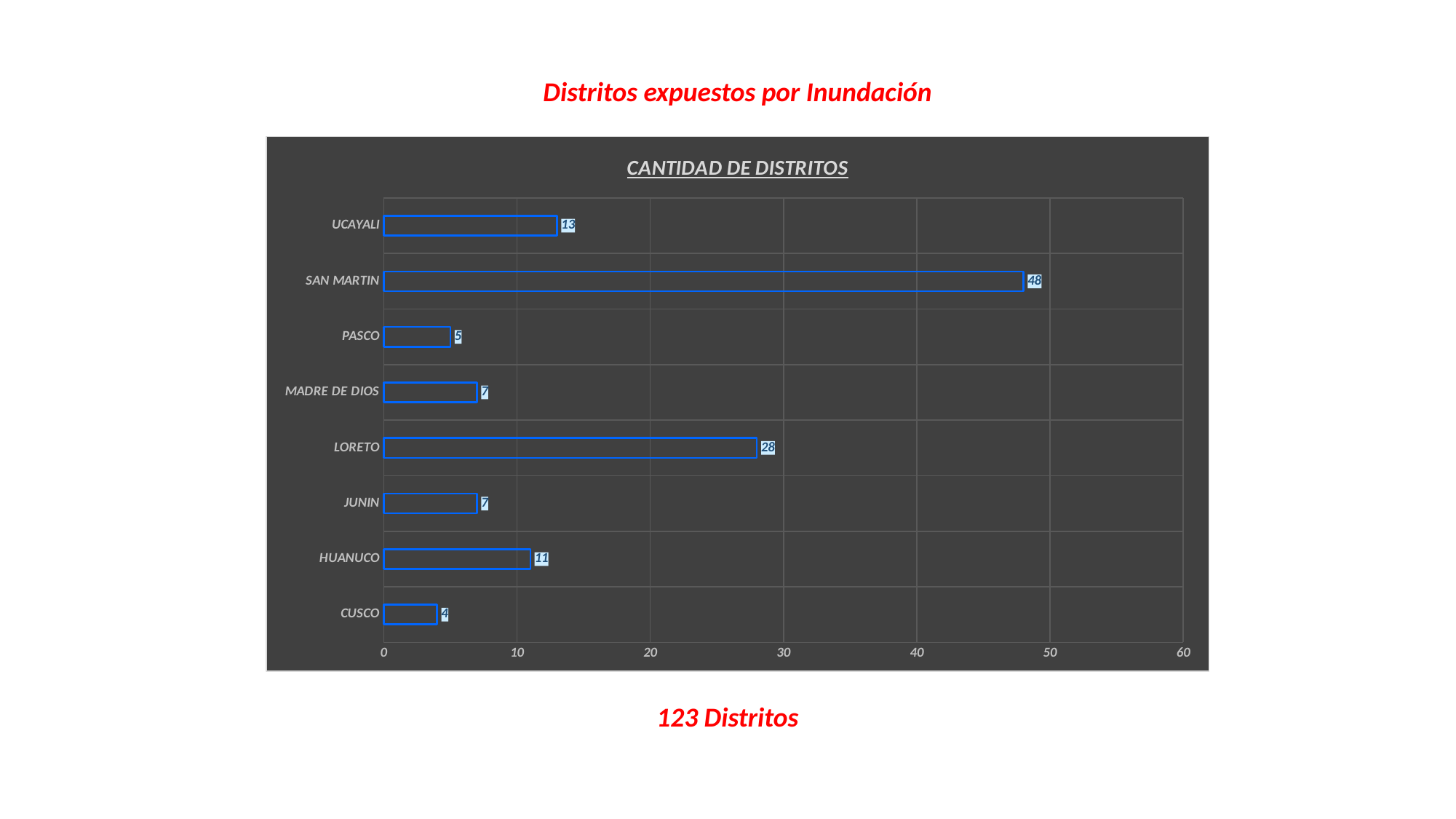
What is the value for LORETO? 28 Which category has the lowest value? CUSCO What is the value for SAN MARTIN? 48 Which is larger, the value for UCAYALI or the value for HUANUCO? UCAYALI What kind of chart is shown? bar chart Is the value for LORETO greater or less than 20? greater What is the title of the chart? CANTIDAD DE DISTRITOS What is the difference between the values for SAN MARTIN and LORETO? 20 What is the difference between the values for UCAYALI and CUSCO? 9 How many categories are shown in the chart? 8 Which category has the highest value? SAN MARTIN What is the value for HUANUCO? 11